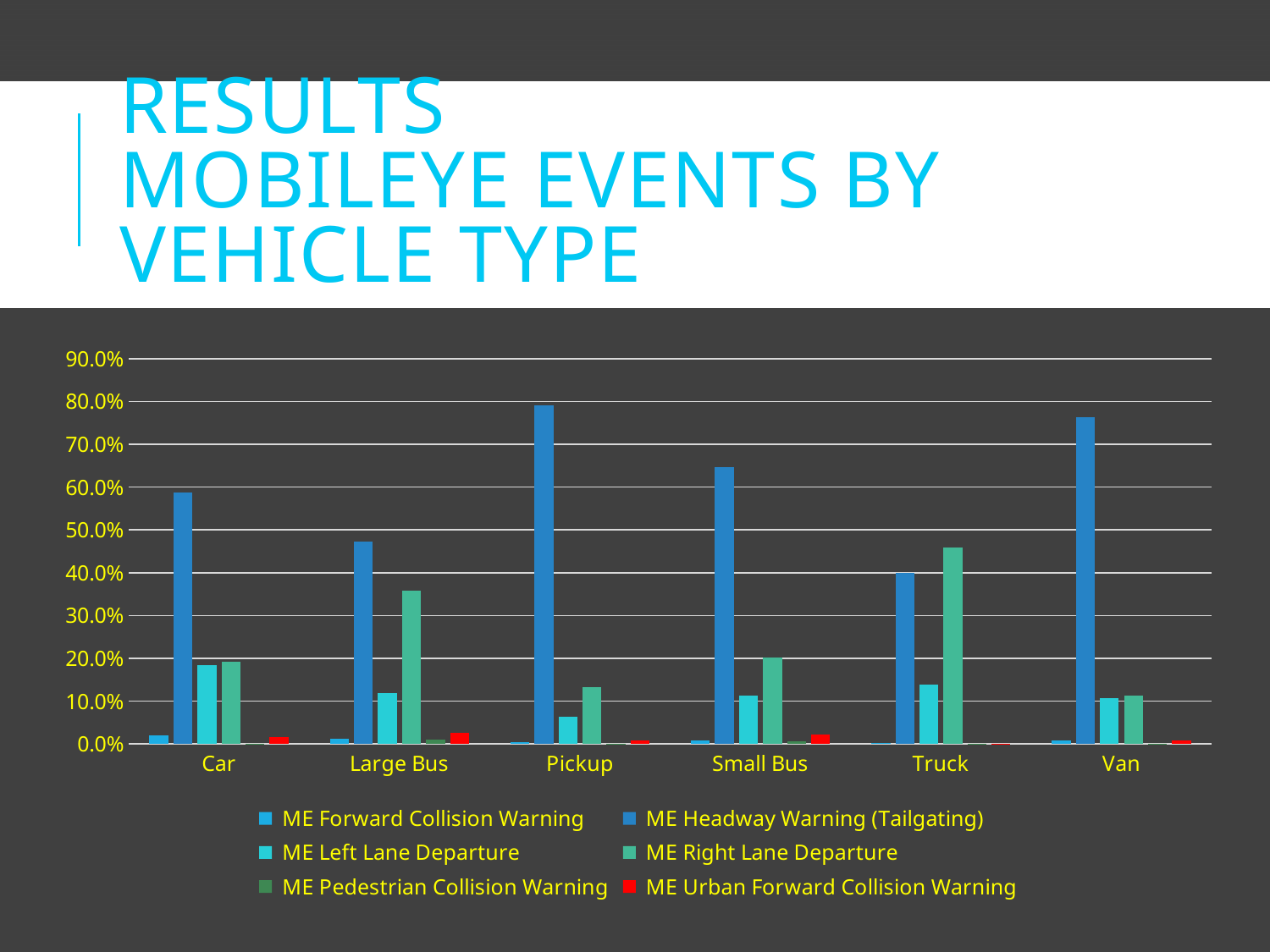
How many vehicle types are shown on the x axis of the chart? 6 For Truck, which is larger: ME Right Lane Departure or ME Headway Warning (Tailgating)? ME Right Lane Departure For Large Bus, which is larger: ME Left Lane Departure or ME Right Lane Departure? ME Right Lane Departure Is the ME Headway Warning (Tailgating) value for Truck greater or less than 50.0%? less Is the ME Headway Warning (Tailgating) value for Pickup greater or less than 70.0%? greater Is the ME Right Lane Departure value for Truck greater or less than 40.0%? greater Which vehicle type has the lowest ME Headway Warning (Tailgating) value? Truck Which vehicle type has the highest ME Right Lane Departure value? Truck How many series does the chart's legend list? 6 What kind of chart is shown on the slide? Bar chart